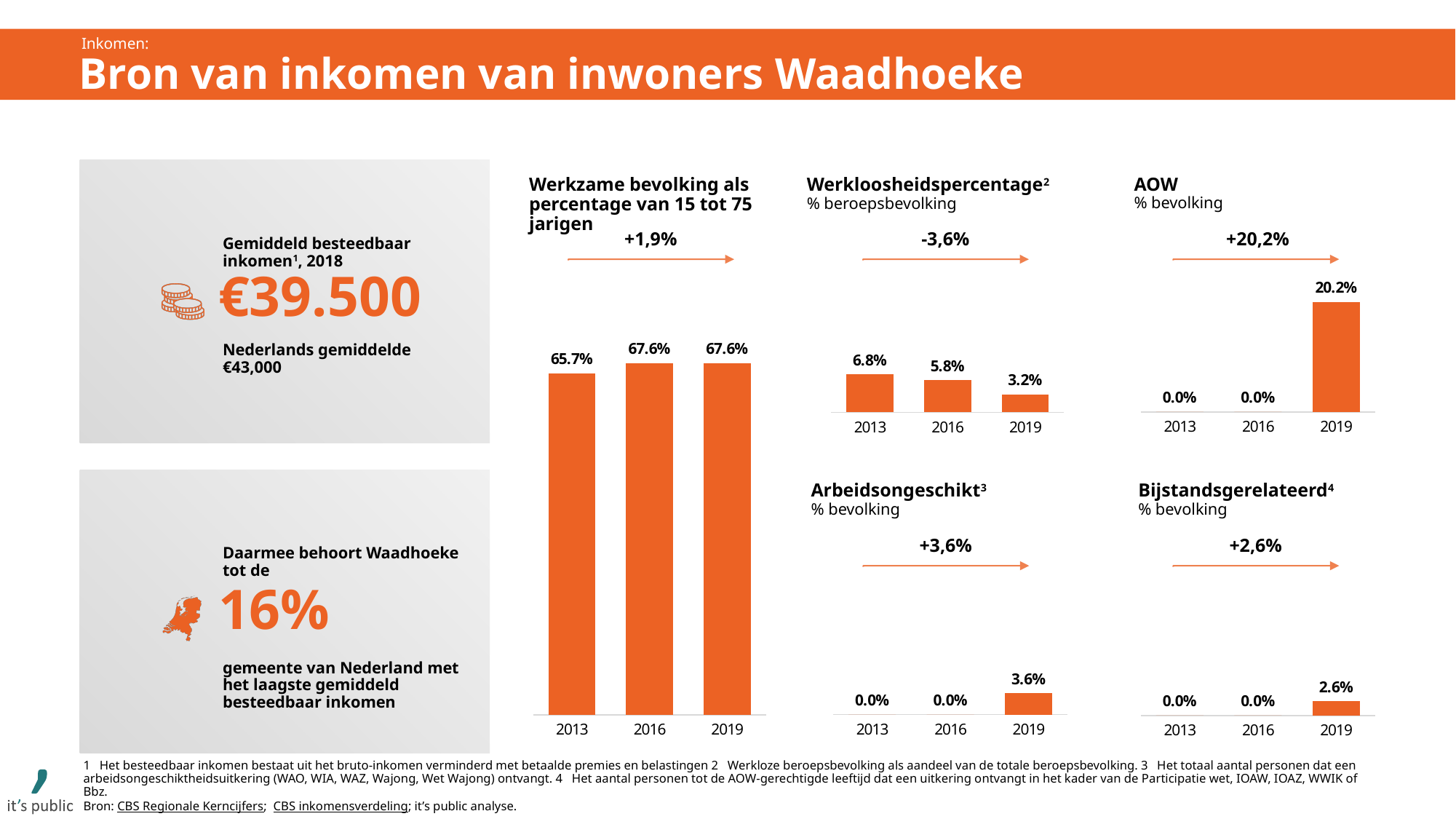
In the 'Werkloosheidspercentage' chart, which year has the lowest value? 2019 In the 'Arbeidsongeschikt' chart, what is the value for 2019? 3.6% In the 'AOW' chart, which year has the highest value? 2019 Which is larger: the 2019 value in the 'Arbeidsongeschikt' chart or the 2019 value in the 'Bijstandsgerelateerd' chart? Arbeidsongeschikt In the 'Werkloosheidspercentage' chart, what is the difference between the 2013 and 2019 values? 3.6% In the 'Bijstandsgerelateerd' chart, what is the value for 2019? 2.6% In the 'Werkloosheidspercentage' chart, what is the value for 2016? 5.8% How many years are shown on the x axis of the 'Werkzame bevolking als percentage van 15 tot 75 jarigen' chart? 3 In the 'AOW' chart, what is the value for 2019? 20.2% In the 'Werkloosheidspercentage' chart, do the values rise or fall from 2013 to 2019? fall In the 'Werkzame bevolking als percentage van 15 tot 75 jarigen' chart, what is the value for 2013? 65.7% In the 'Werkzame bevolking als percentage van 15 tot 75 jarigen' chart, what is the value for 2019? 67.6%